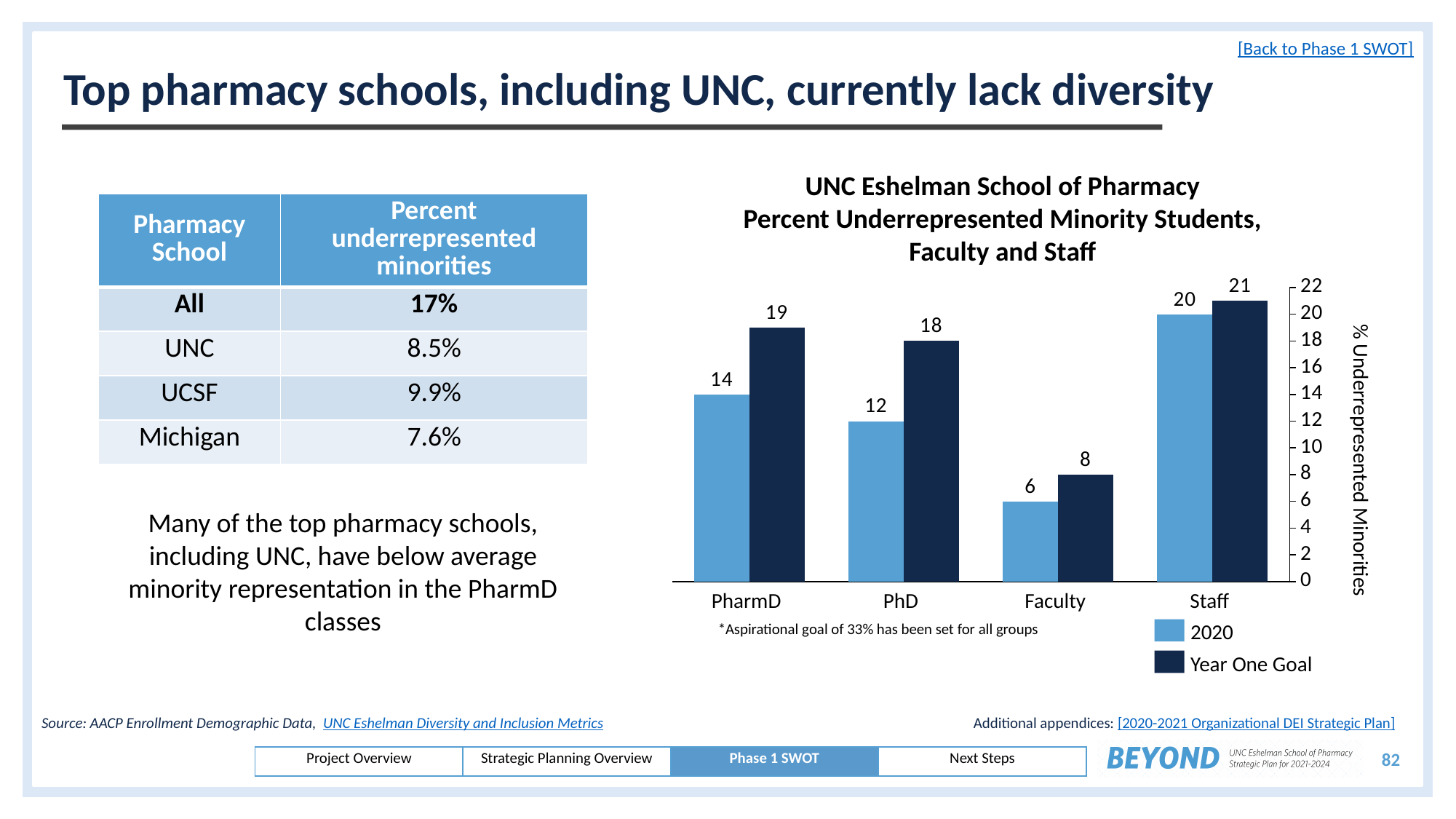
What is the Year One Goal value for PhD? 18 What is the label of the vertical axis of the chart? % Underrepresented Minorities Which category has the lowest Year One Goal value? Faculty Which is larger, the 2020 value for PharmD or the 2020 value for PhD? PharmD What is the 2020 value for Faculty? 6 How many categories are shown on the x axis of the chart? 4 What is the 2020 value for PharmD? 14 What is the Year One Goal value for Staff? 21 What is the difference between the Year One Goal and 2020 values for PhD? 6 How many series does the chart legend list? 2 Which category has the highest 2020 value? Staff What kind of chart is shown on the slide? Bar chart